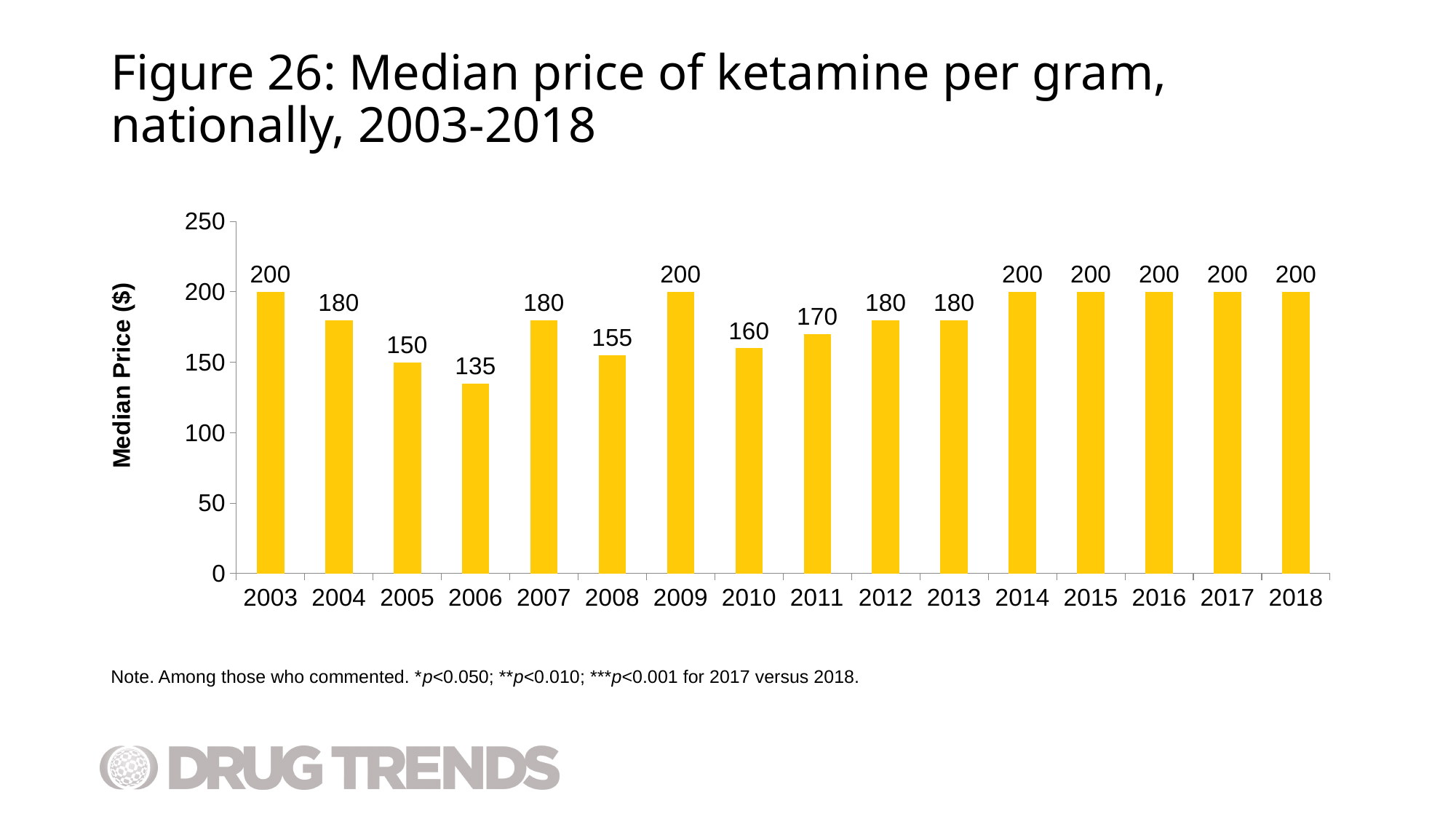
Which year has the lowest median price of ketamine per gram? 2006 What kind of chart is shown on the slide? Bar chart Is the median price for 2010 greater or less than 150? greater Which is larger, the median price in 2005 or the median price in 2008? 2008 What is the median price of ketamine per gram in 2011? 170 What is the difference between the median price in 2003 and the median price in 2006? 65 How many years are shown on the x axis? 16 What is the median price of ketamine per gram in 2006? 135 Does the median price rise or fall from 2006 to 2009? Rise What is the median price of ketamine per gram in 2008? 155 What is the difference between the median price in 2012 and the median price in 2010? 20 What is the label of the y axis? Median Price ($)